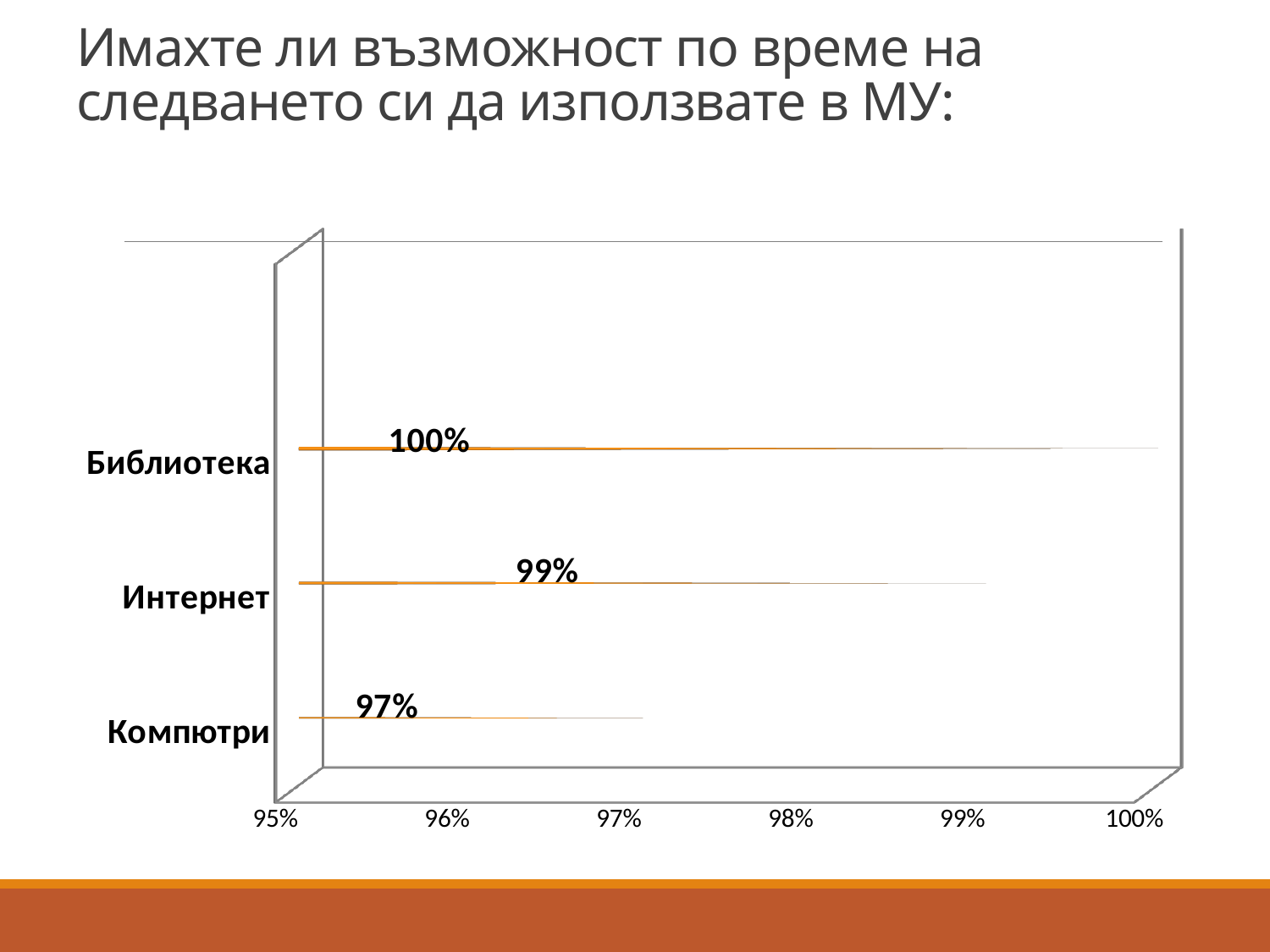
What is the lowest value shown on the horizontal axis? 95% What is the value for Интернет? 99% What is the difference between the values for Интернет and Компютри? 2% What is the value for Компютри? 97% Which category has the highest value? Библиотека Is the value for Компютри greater or less than 98%? less How many categories are shown in the chart? 3 What is the value for Библиотека? 100% What kind of chart is shown on the slide? bar chart What is the difference between the values for Библиотека and Компютри? 3% Which is larger, the value for Интернет or the value for Компютри? Интернет Which category has the lowest value? Компютри